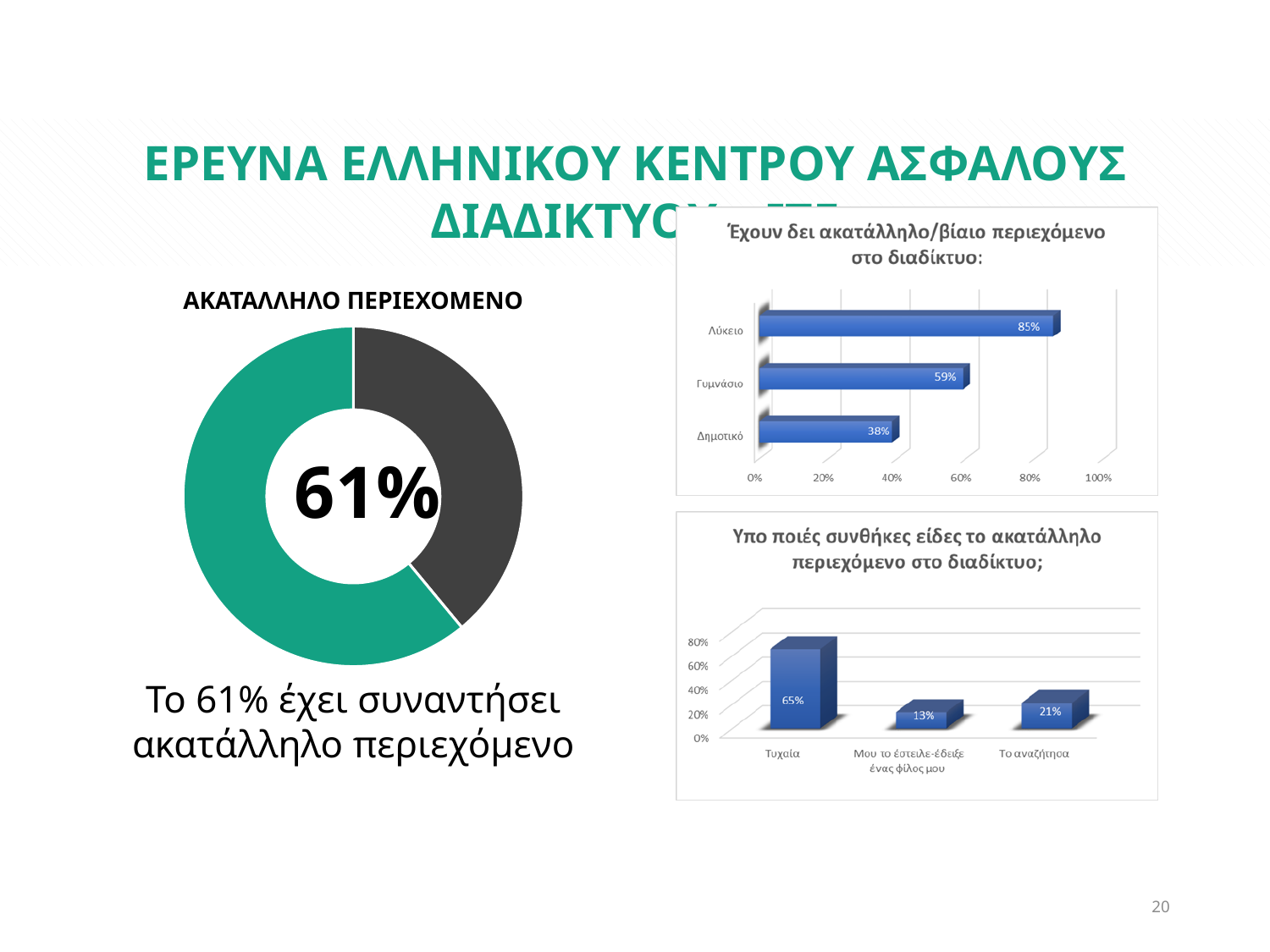
What kind of chart is the one titled 'Έχουν δει ακατάλληλο/βίαιο περιεχόμενο στο διαδίκτυο:'? Bar chart In the chart titled 'Υπο ποιές συνθήκες είδες το ακατάλληλο περιεχόμενο στο διαδίκτυο;', what is the value for Το αναζήτησα? 21% In the chart titled 'Έχουν δει ακατάλληλο/βίαιο περιεχόμενο στο διαδίκτυο:', which category has the lowest value? Δημοτικό In the chart titled 'Έχουν δει ακατάλληλο/βίαιο περιεχόμενο στο διαδίκτυο:', how many categories are shown? 3 What percentage is shown in the centre of the doughnut chart titled 'ΑΚΑΤΑΛΛΗΛΟ ΠΕΡΙΕΧΟΜΕΝΟ'? 61% In the chart titled 'Υπο ποιές συνθήκες είδες το ακατάλληλο περιεχόμενο στο διαδίκτυο;', what is the value for Τυχαία? 65% In the chart titled 'Έχουν δει ακατάλληλο/βίαιο περιεχόμενο στο διαδίκτυο:', what is the value for Λύκειο? 85% In the chart titled 'Υπο ποιές συνθήκες είδες το ακατάλληλο περιεχόμενο στο διαδίκτυο;', which is larger: the value for 'Μου το έστειλε-έδειξε ένας φίλος μου' or the value for 'Το αναζήτησα'? Το αναζήτησα In the chart titled 'Υπο ποιές συνθήκες είδες το ακατάλληλο περιεχόμενο στο διαδίκτυο;', which category has the highest value? Τυχαία In the chart titled 'Έχουν δει ακατάλληλο/βίαιο περιεχόμενο στο διαδίκτυο:', what is the value for Δημοτικό? 38% In the chart titled 'Έχουν δει ακατάλληλο/βίαιο περιεχόμενο στο διαδίκτυο:', what is the difference between the values for Λύκειο and Γυμνάσιο? 26% In the chart titled 'Υπο ποιές συνθήκες είδες το ακατάλληλο περιεχόμενο στο διαδίκτυο;', what is the difference between the values for Τυχαία and Το αναζήτησα? 44%